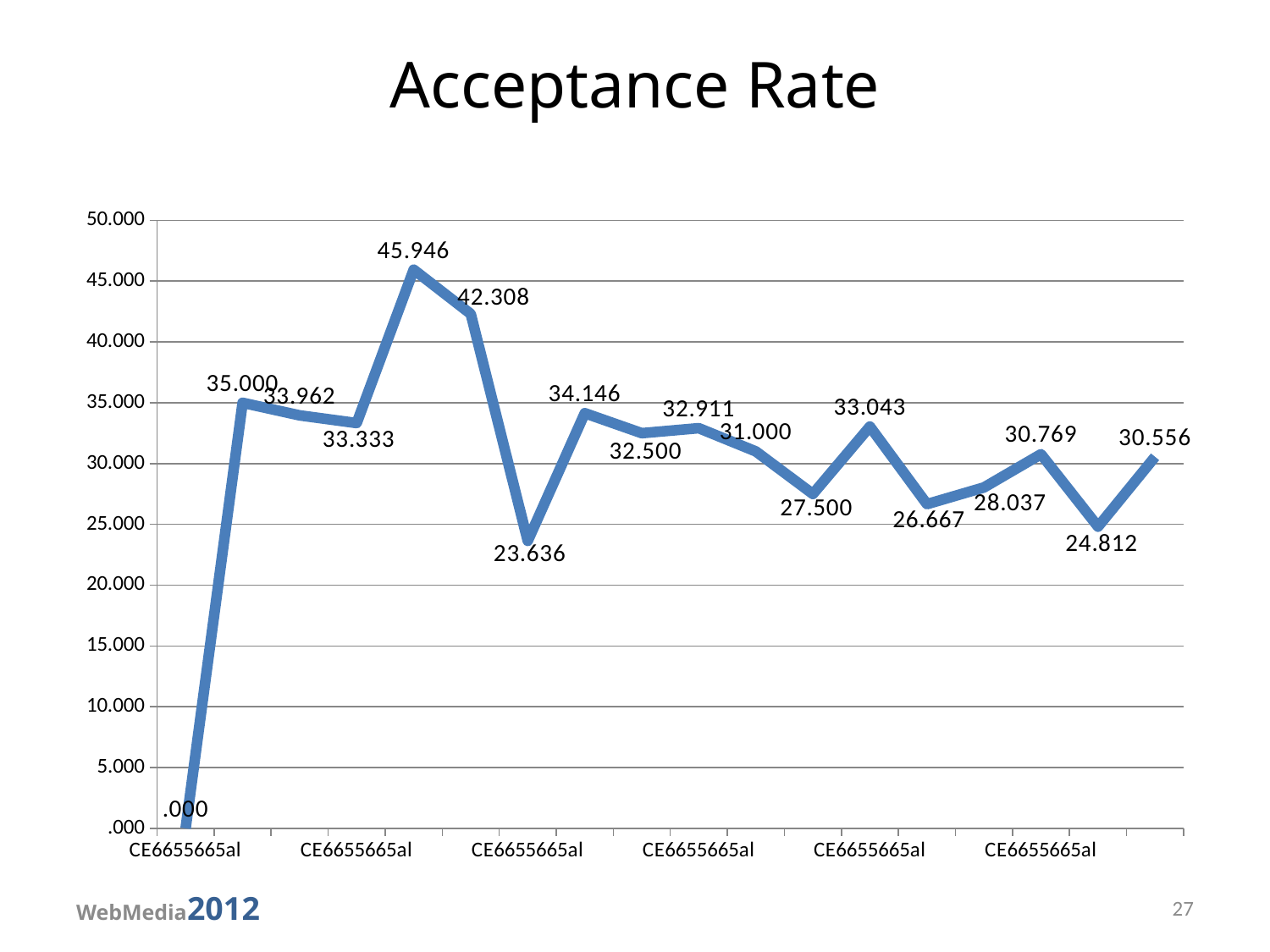
Is the value of the last data point greater or less than 30.000? greater What is the lowest value labelled on the line? .000 What is the value of the last data point on the line? 30.556 Does the line rise or fall between the first and second data points? rise What is the highest value labelled on the line? 45.946 What is the difference between the values 30.769 and 24.812? 5.957 What is the difference between the highest labelled value (45.946) and the value that follows it (42.308)? 3.638 What is the value of the second data point on the line? 35.000 How many data points are plotted on the line? 18 Which is larger, the value labelled 33.043 or the value labelled 26.667? 33.043 What is the title of the chart? Acceptance Rate What kind of chart is shown on the slide? line chart